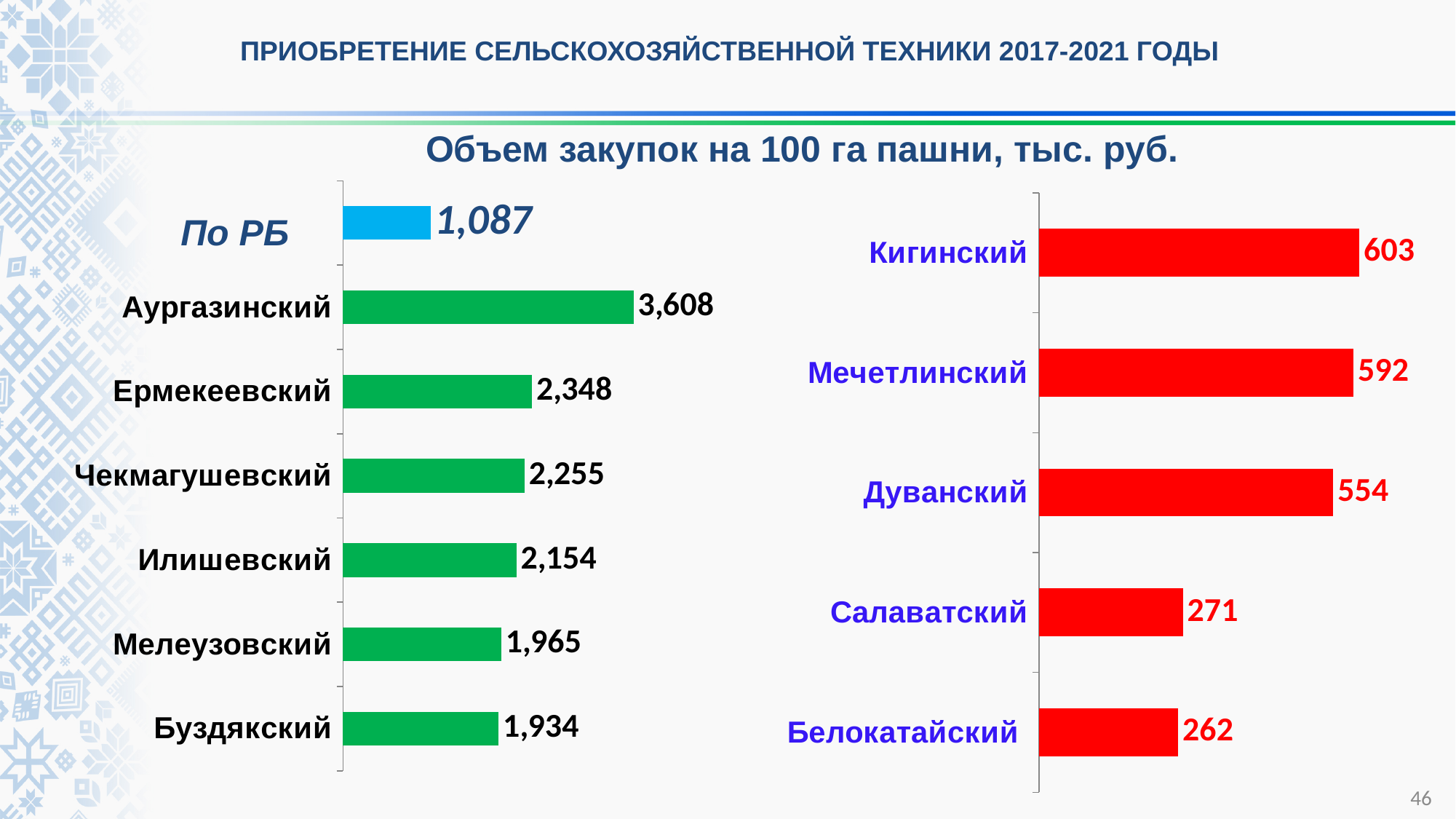
What type of chart is the left chart? Bar chart How many bars are shown in the right chart? 5 In the right chart, what is the value for Дуванский? 554 In the right chart, which district has the highest value? Кигинский In the left chart, which district has the lowest value? Буздякский In the left chart, what is the value for Аургазинский? 3,608 In the left chart, which is larger: Илишевский or Мелеузовский? Илишевский What is the title shown above the charts? Объем закупок на 100 га пашни, тыс. руб. In the left chart, what is the difference between Аургазинский and Ермекеевский? 1,260 In the right chart, what is the difference between Кигинский and Салаватский? 332 In the left chart, what is the value for По РБ? 1,087 In the right chart, which district has the lowest value? Белокатайский